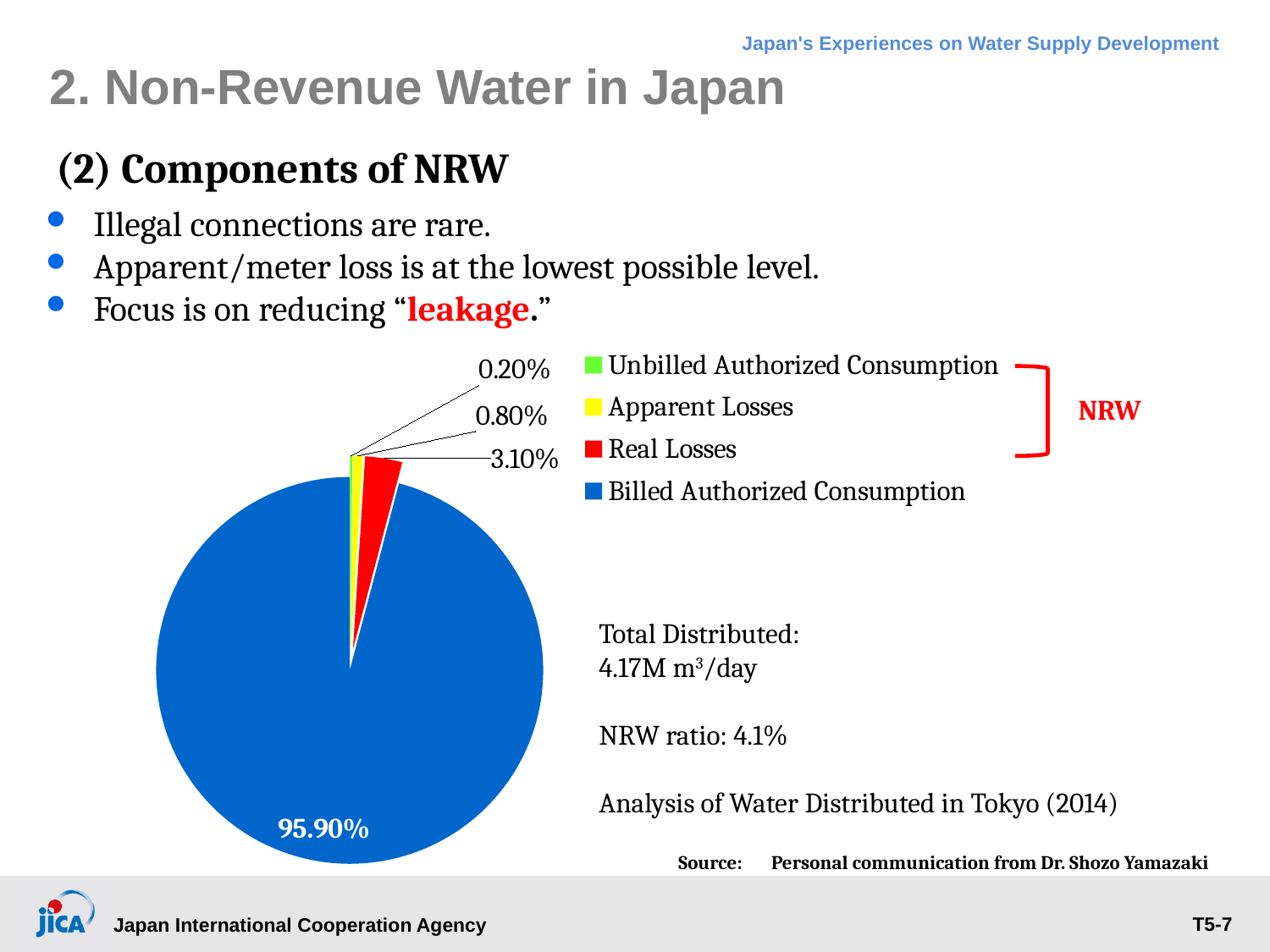
What share of the pie is Real Losses? 3.10% What is the combined share of Unbilled Authorized Consumption, Apparent Losses and Real Losses? 4.10% How many categories does the pie chart have? 4 Which category has the smallest slice of the pie? Unbilled Authorized Consumption What share of the pie is Apparent Losses? 0.80% What kind of chart is shown on the slide? pie chart Which colour represents Real Losses in the pie chart? red What share of the pie is Unbilled Authorized Consumption? 0.20% What share of the pie is Billed Authorized Consumption? 95.90% What is the difference in percentage points between Real Losses and Apparent Losses? 2.30% Which is larger, Real Losses or Apparent Losses? Real Losses Which category has the largest slice of the pie? Billed Authorized Consumption